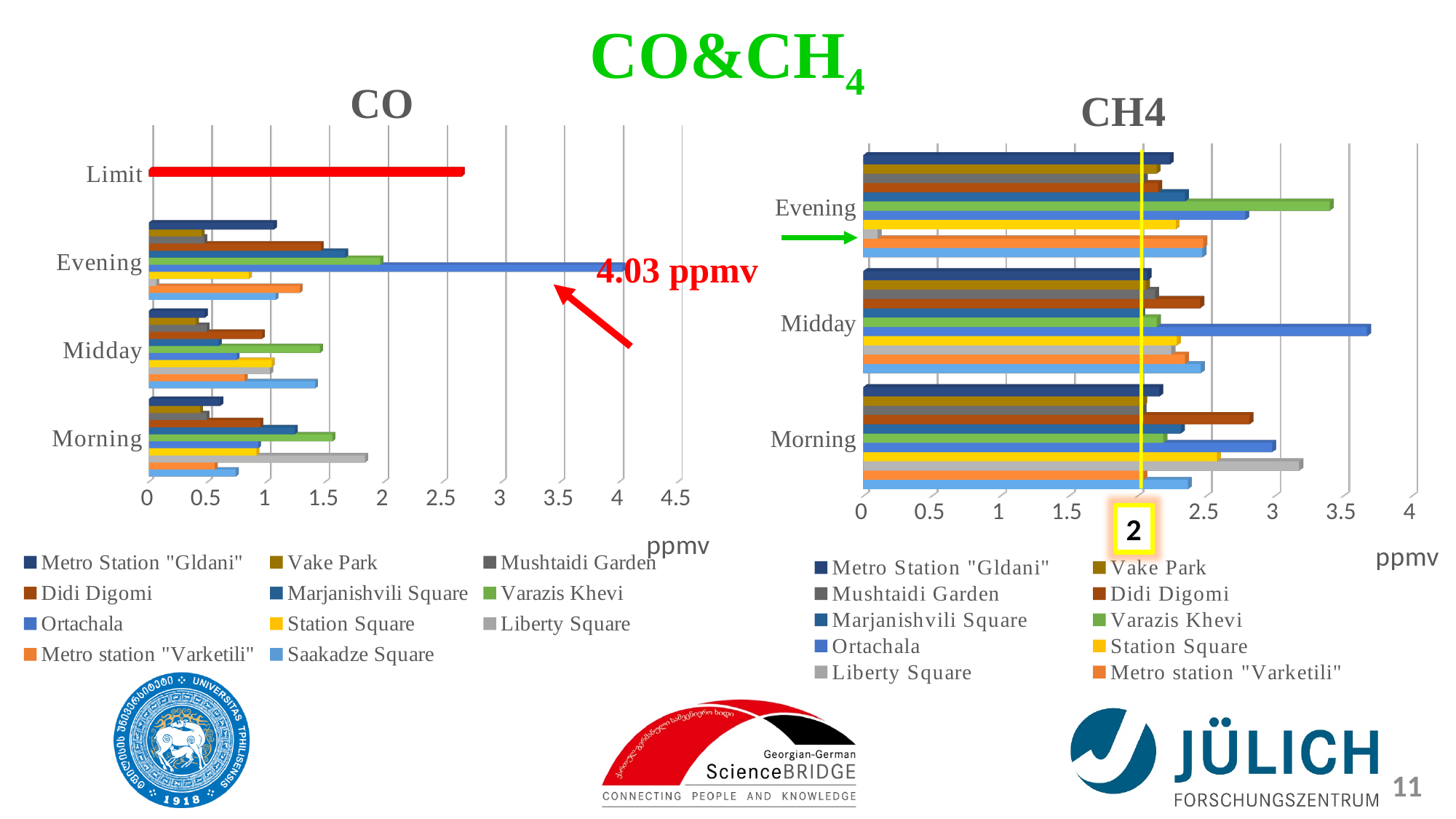
How many series does the legend of the CH4 chart list? 10 In the CH4 chart, which location has the highest Midday value? Ortachala In the CO chart, which location has the highest Evening value? Ortachala In the CH4 chart, is the Ortachala Midday value greater or less than 3.5? greater How many categories are shown on the y axis of the CO chart? 4 What kind of chart is the CO chart? bar chart In the CO chart, is the Limit value greater or less than 2.5? greater In the CH4 chart, which location has the highest Evening value? Varazis Khevi In the CO chart, what value is annotated for the Ortachala bar in the Evening group? 4.03 ppmv In the CO chart, which is larger: the Limit bar or the Ortachala Evening bar? Ortachala Evening bar In the CH4 chart, what value on the x axis is marked by the vertical yellow line? 2 How many series does the legend of the CO chart list? 11